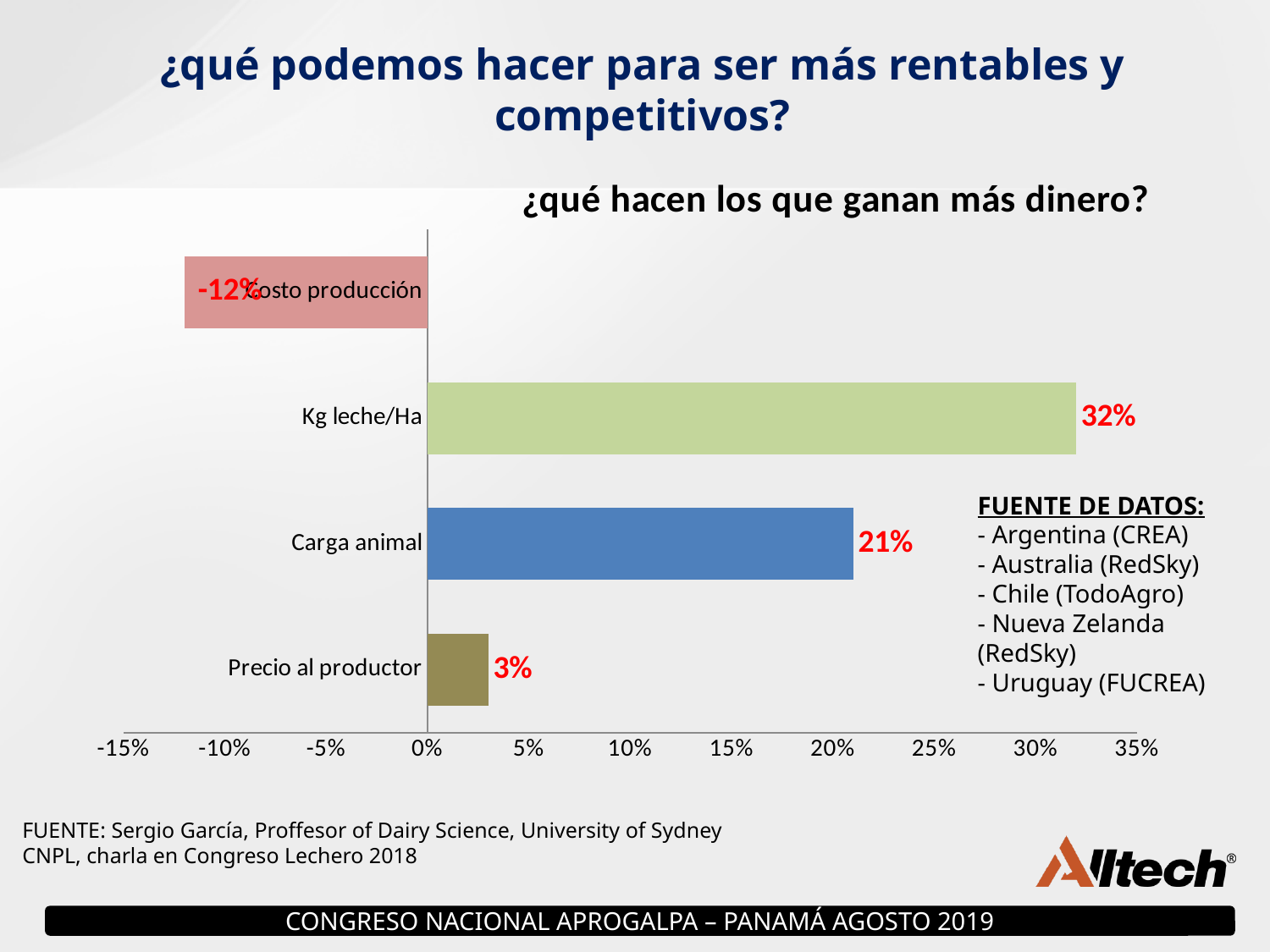
What is the difference between the values for Kg leche/Ha and Carga animal? 11% What is the value shown for Carga animal? 21% What is the value shown for Precio al productor? 3% What is the title of the chart? ¿qué hacen los que ganan más dinero? How many categories are plotted in the chart? 4 Which category has the highest value? Kg leche/Ha Which is larger, the value for Carga animal or the value for Precio al productor? Carga animal Which category has the lowest value? Costo producción What kind of chart is shown on the slide? Bar chart What is the difference between the values for Carga animal and Precio al productor? 18% What is the value shown for Costo producción? -12% What is the value shown for Kg leche/Ha? 32%